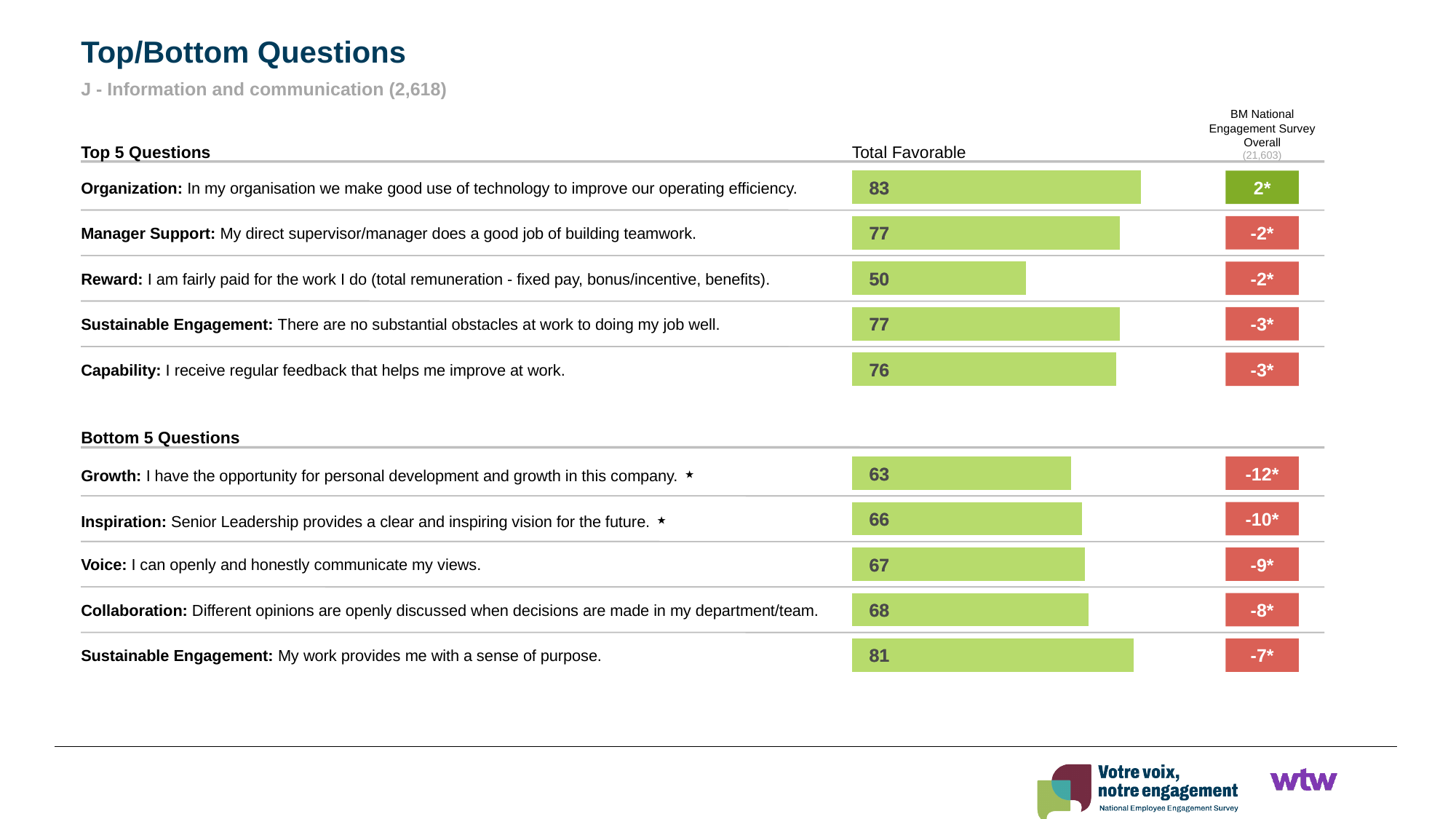
In the Top 5 Questions chart, what is the difference in Total Favorable between the Organization question (83) and the Capability question (76)? 7 In the Top 5 Questions chart, which question has the lowest Total Favorable value? Reward: I am fairly paid for the work I do (total remuneration - fixed pay, bonus/incentive, benefits). In the Top 5 Questions chart, which question has the highest Total Favorable value? Organization: In my organisation we make good use of technology to improve our operating efficiency. In the Bottom 5 Questions chart, which question has the highest Total Favorable value? Sustainable Engagement: My work provides me with a sense of purpose. In the Bottom 5 Questions chart, which has a larger Total Favorable value: the Inspiration question or the Collaboration question? Collaboration In the Bottom 5 Questions chart, which question has the lowest Total Favorable value? Growth: I have the opportunity for personal development and growth in this company. What type of chart is used to show the Total Favorable values on this slide? Bar chart In the Top 5 Questions chart, what is the Total Favorable value for the Reward question about being fairly paid? 50 In the Bottom 5 Questions chart, what is the Total Favorable value for the Voice question about openly and honestly communicating views? 67 In the Bottom 5 Questions chart, what is the BM National Engagement Survey Overall difference shown for the Growth question? -12* How many questions are plotted in the Bottom 5 Questions chart? 5 In the Top 5 Questions chart, what is the Total Favorable value for the Organization question about making good use of technology? 83